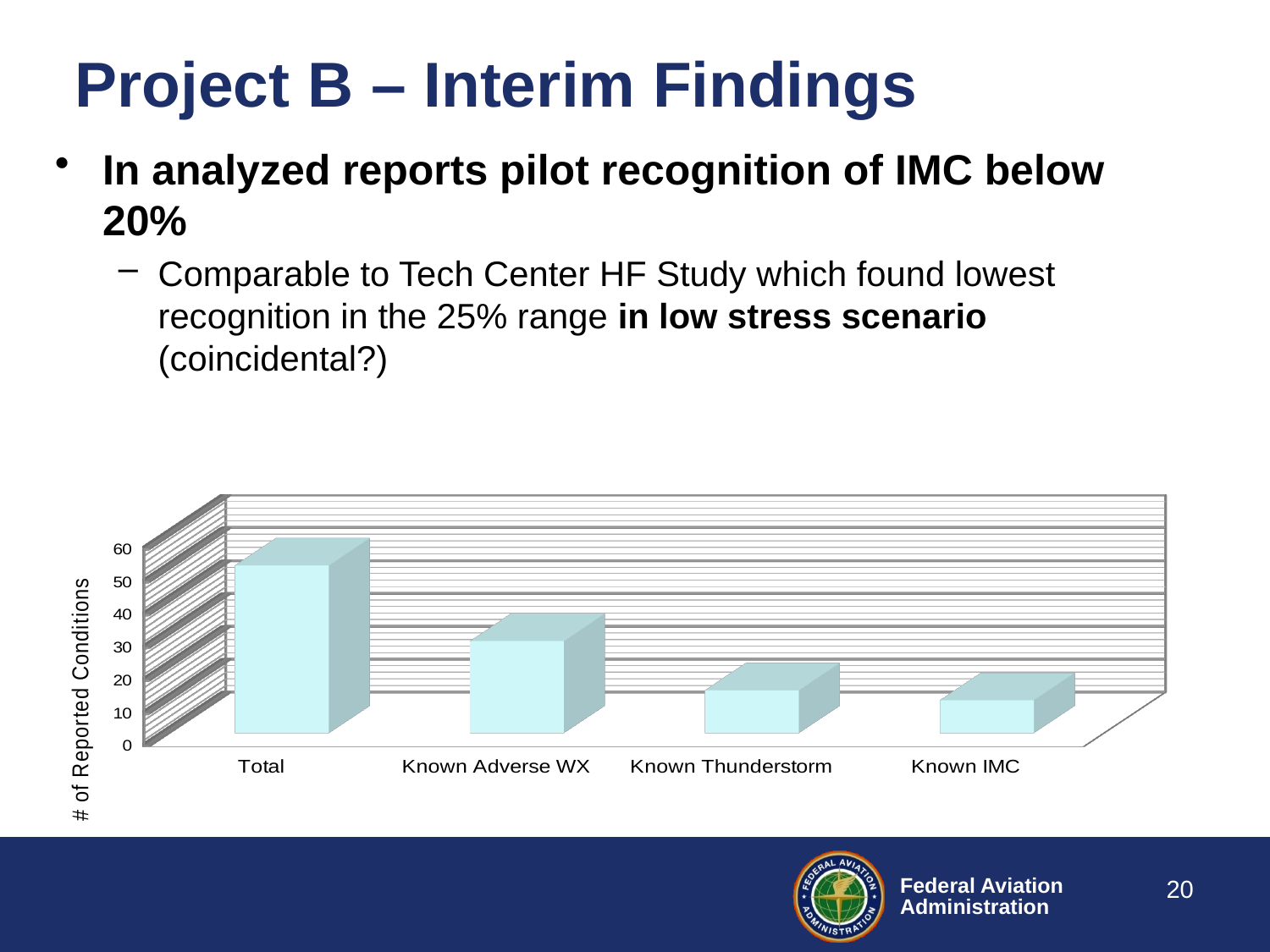
Which is larger, the value for Total or the value for Known Adverse WX? Total Is the value for Total greater or less than 40? greater Is the value for Known Adverse WX greater or less than 20? greater Do the values rise or fall moving from left to right along the x axis? fall What kind of chart is shown on the slide? bar chart Which category has the highest value in the chart? Total How many categories are plotted on the x axis of the chart? 4 Which category has the lowest value in the chart? Known IMC Which is larger, the value for Known Adverse WX or the value for Known Thunderstorm? Known Adverse WX Is the value for Known Adverse WX greater or less than 40? less What is the title of the vertical axis of the chart? # of Reported Conditions